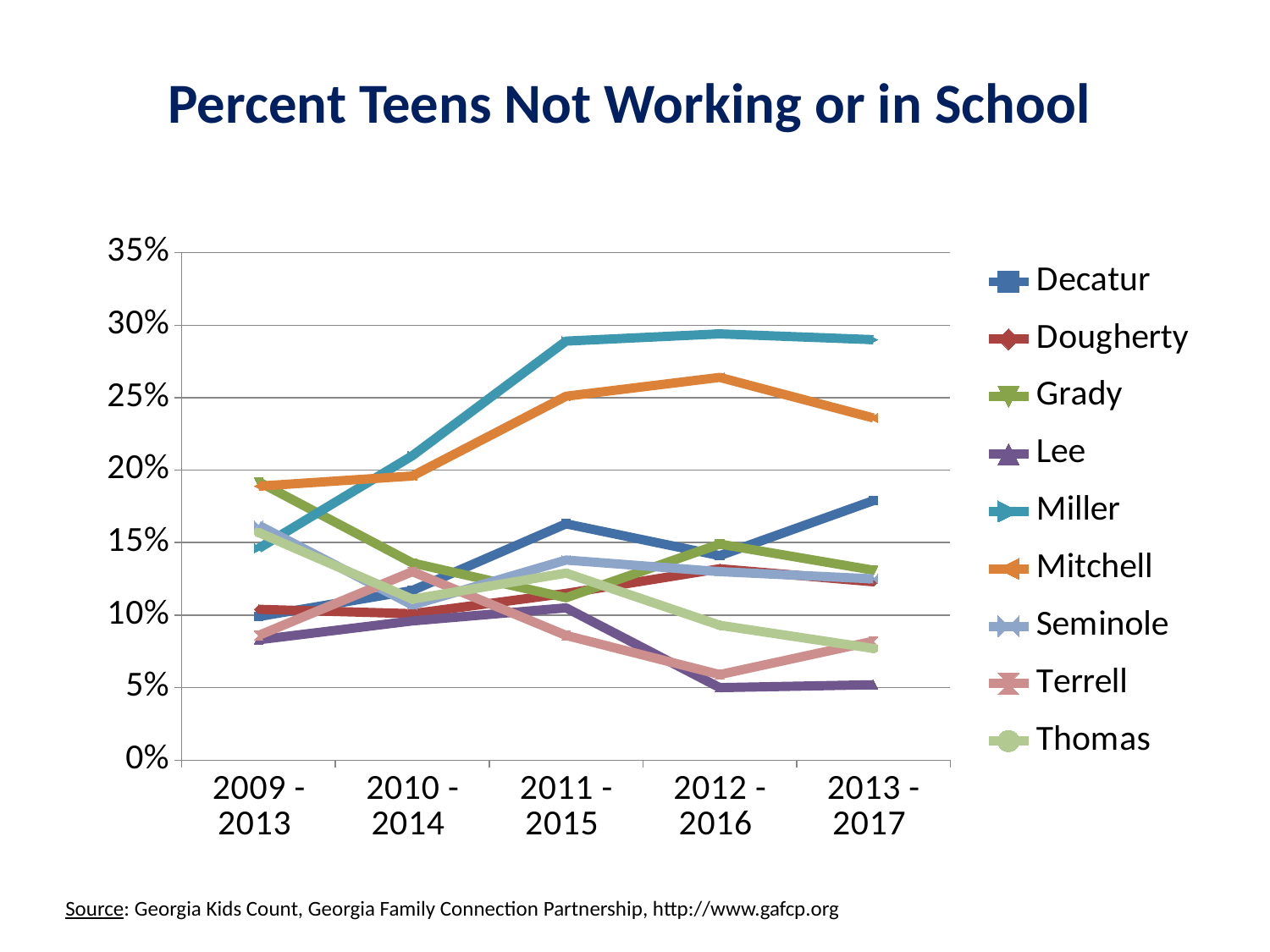
What kind of chart is shown on the slide? line chart In 2013 - 2017, which is larger, the value for Grady or the value for Thomas? Grady Is the value for Lee in 2012 - 2016 greater or less than 10%? less Which county has the highest value in 2013 - 2017? Miller Is the value for Decatur in 2013 - 2017 greater or less than 15%? greater What is the title of the chart? Percent Teens Not Working or in School How many series does the legend list? 9 Does the value for Miller rise or fall from 2009 - 2013 to 2011 - 2015? rise Is the value for Miller in 2012 - 2016 greater or less than 25%? greater How many time periods are shown on the x axis? 5 Which county has the lowest value in 2013 - 2017? Lee In 2011 - 2015, which is larger, the value for Mitchell or the value for Decatur? Mitchell